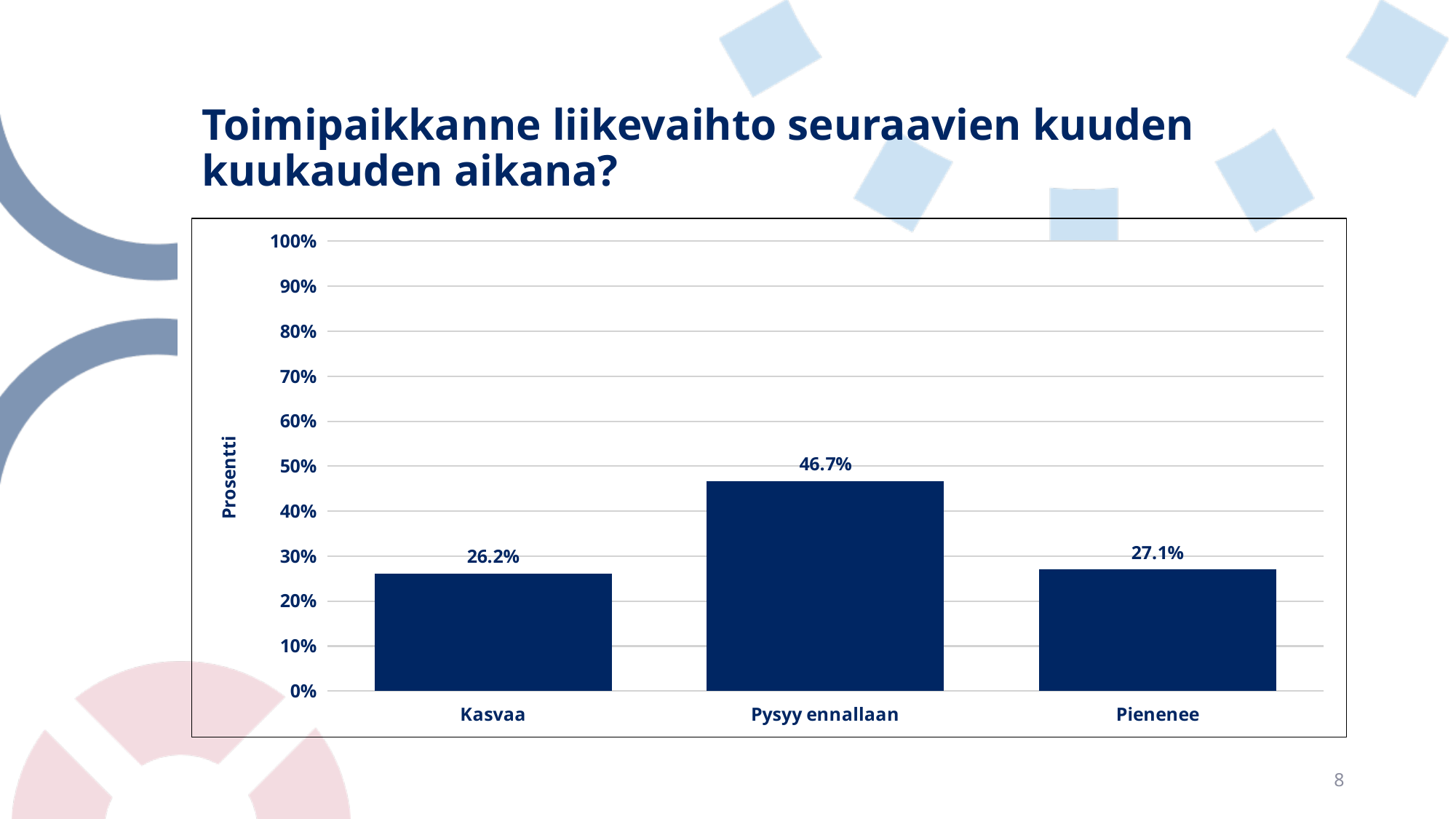
What is the difference between the values for Pienenee and Kasvaa? 0.9% What is the value for Pysyy ennallaan? 46.7% What is the label of the y axis? Prosentti How many categories are shown on the x axis? 3 Which is larger, the value for Pysyy ennallaan or the value for Pienenee? Pysyy ennallaan Is the value for Pysyy ennallaan greater or less than 40%? greater What kind of chart is shown on the slide? bar chart Which category has the highest value? Pysyy ennallaan What is the difference between the values for Pysyy ennallaan and Kasvaa? 20.5% What is the value for Pienenee? 27.1% Which category has the lowest value? Kasvaa What is the value for Kasvaa? 26.2%